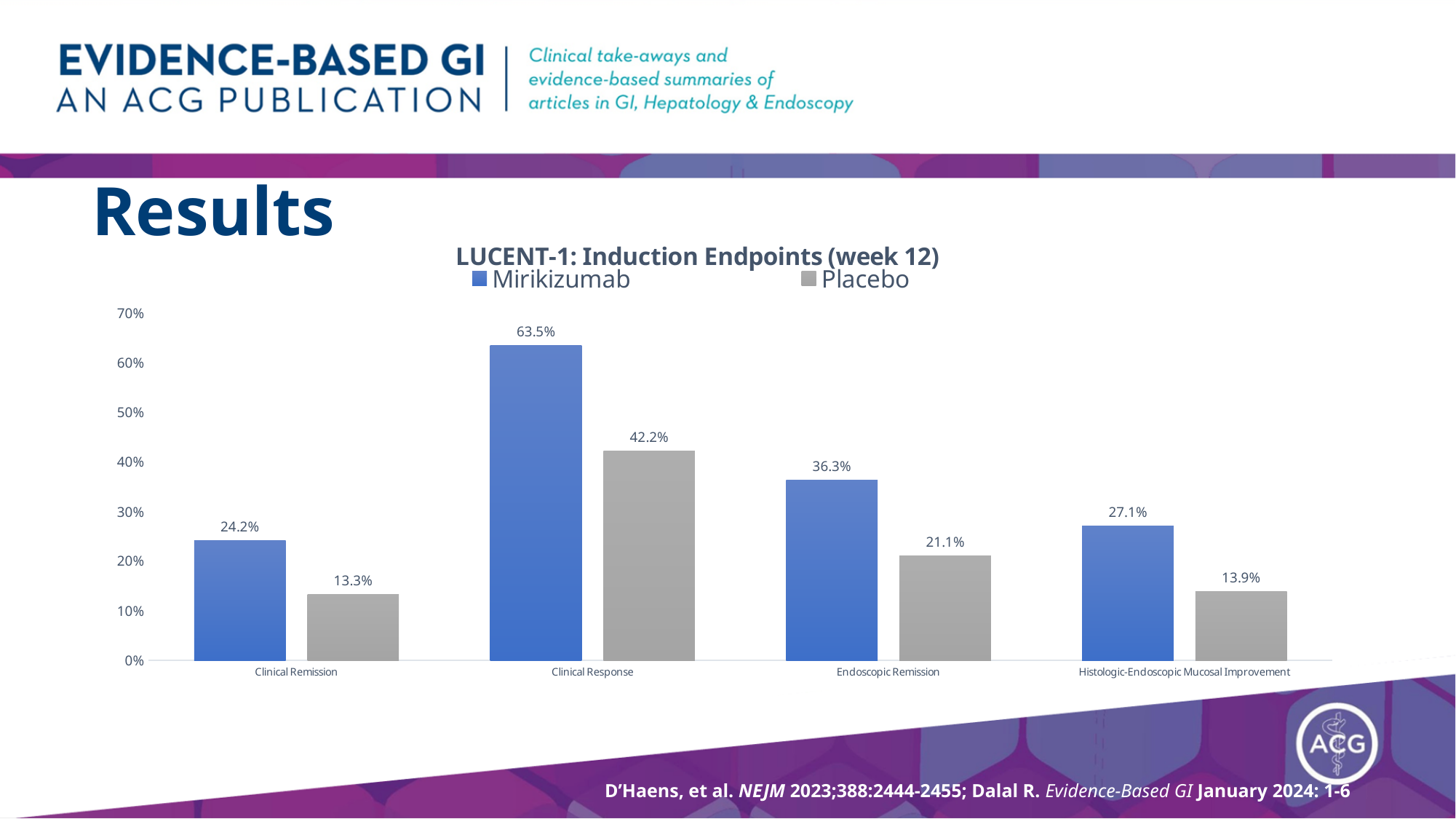
What is the difference between the Mirikizumab and Placebo values for Clinical Response? 21.3% How many series does the legend list? 2 What is the Placebo value for Histologic-Endoscopic Mucosal Improvement? 13.9% What is the title of the chart? LUCENT-1: Induction Endpoints (week 12) How many endpoint categories are shown on the x axis? 4 Which endpoint has the highest Mirikizumab value? Clinical Response What is the Placebo value for Endoscopic Remission? 21.1% Is the Mirikizumab value for Clinical Response greater or less than 60%? greater Which is larger for Endoscopic Remission, the Mirikizumab value or the Placebo value? Mirikizumab Which endpoint has the lowest Placebo value? Clinical Remission What kind of chart is shown on the slide? Bar chart What is the Mirikizumab value for Clinical Remission? 24.2%